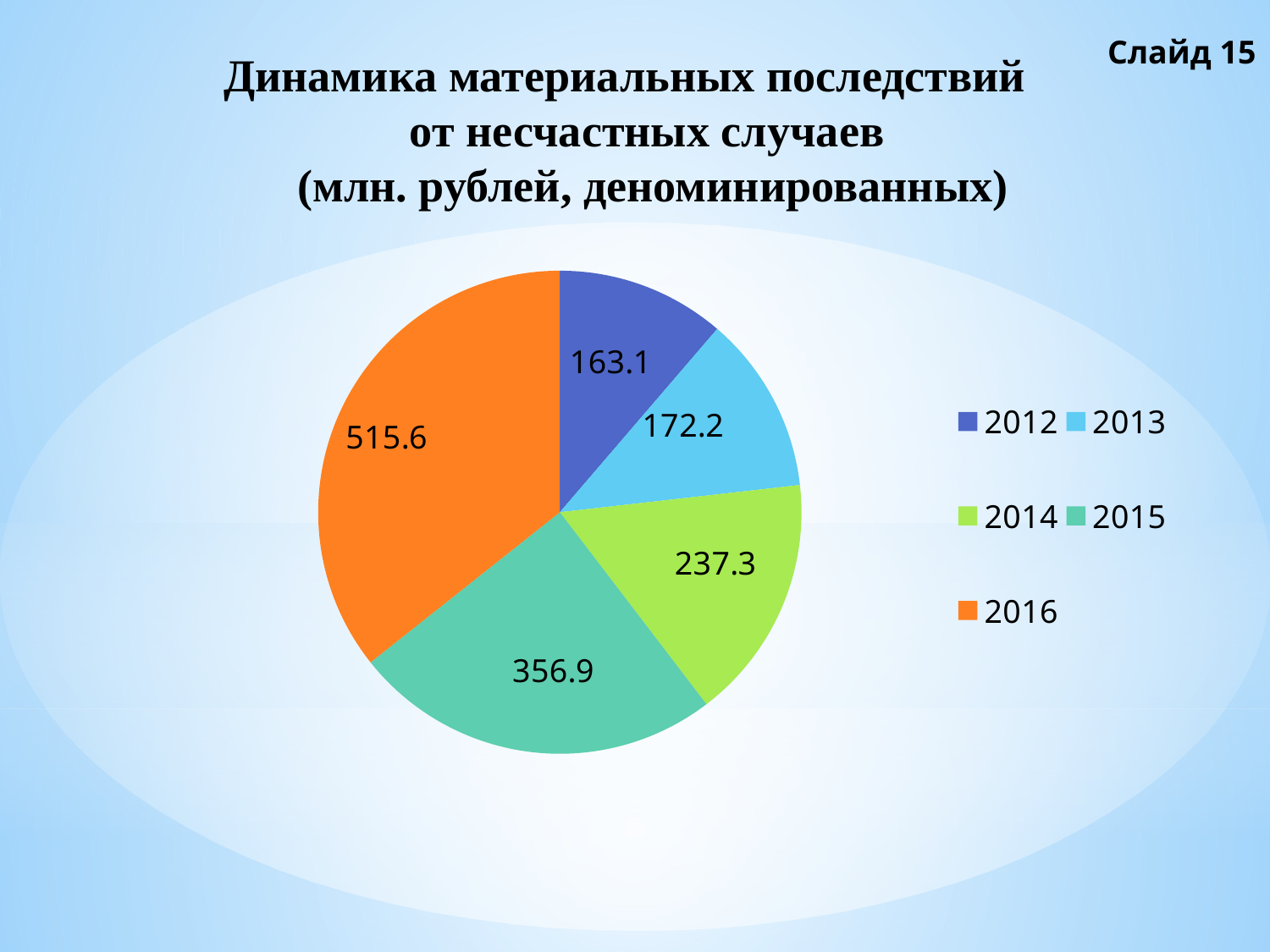
Which is larger, the value for 2014 or the value for 2013? 2014 What is the value for 2012 in the pie chart? 163.1 Do the values rise or fall from 2012 to 2016? rise What is the value for 2016 in the pie chart? 515.6 What is the difference between the values for 2015 and 2014? 119.6 What is the difference between the values for 2016 and 2015? 158.7 What kind of chart is shown on the slide? pie chart What is the value for 2014 in the pie chart? 237.3 How many slices does the pie chart have? 5 Which year has the largest slice in the pie chart? 2016 How many entries does the legend list? 5 Which year has the smallest slice in the pie chart? 2012